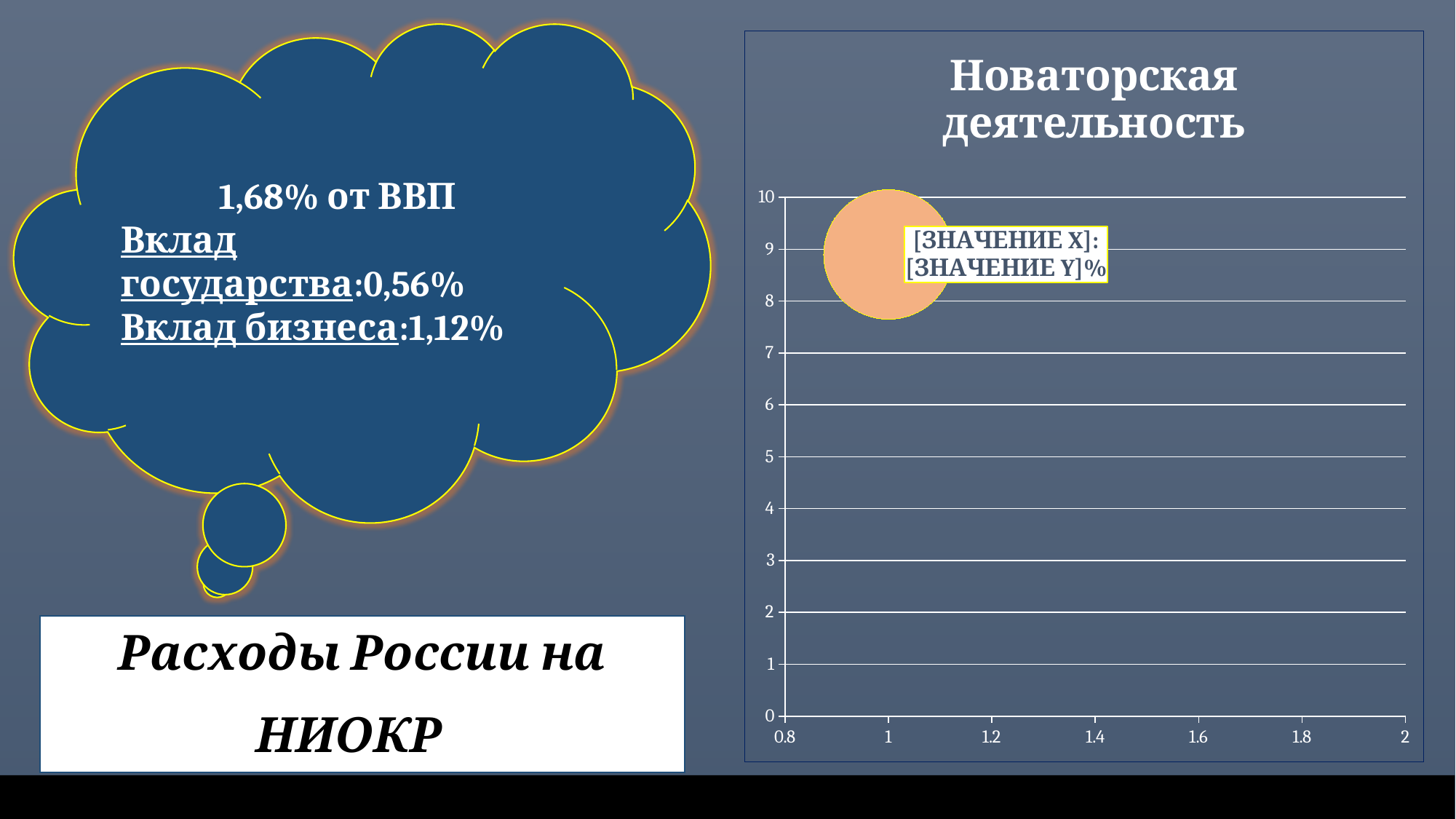
Is the x-value of the bubble on the chart greater or less than 1.4? less What is the highest value shown on the chart's y-axis? 10 What kind of chart is shown on the slide? bubble chart Is the y-value of the bubble on the chart greater or less than 7? greater What is the title of the chart on the slide? Новаторская деятельность Is the y-value of the bubble on the chart greater or less than 3? greater How many data points (bubbles) are plotted on the chart? 1